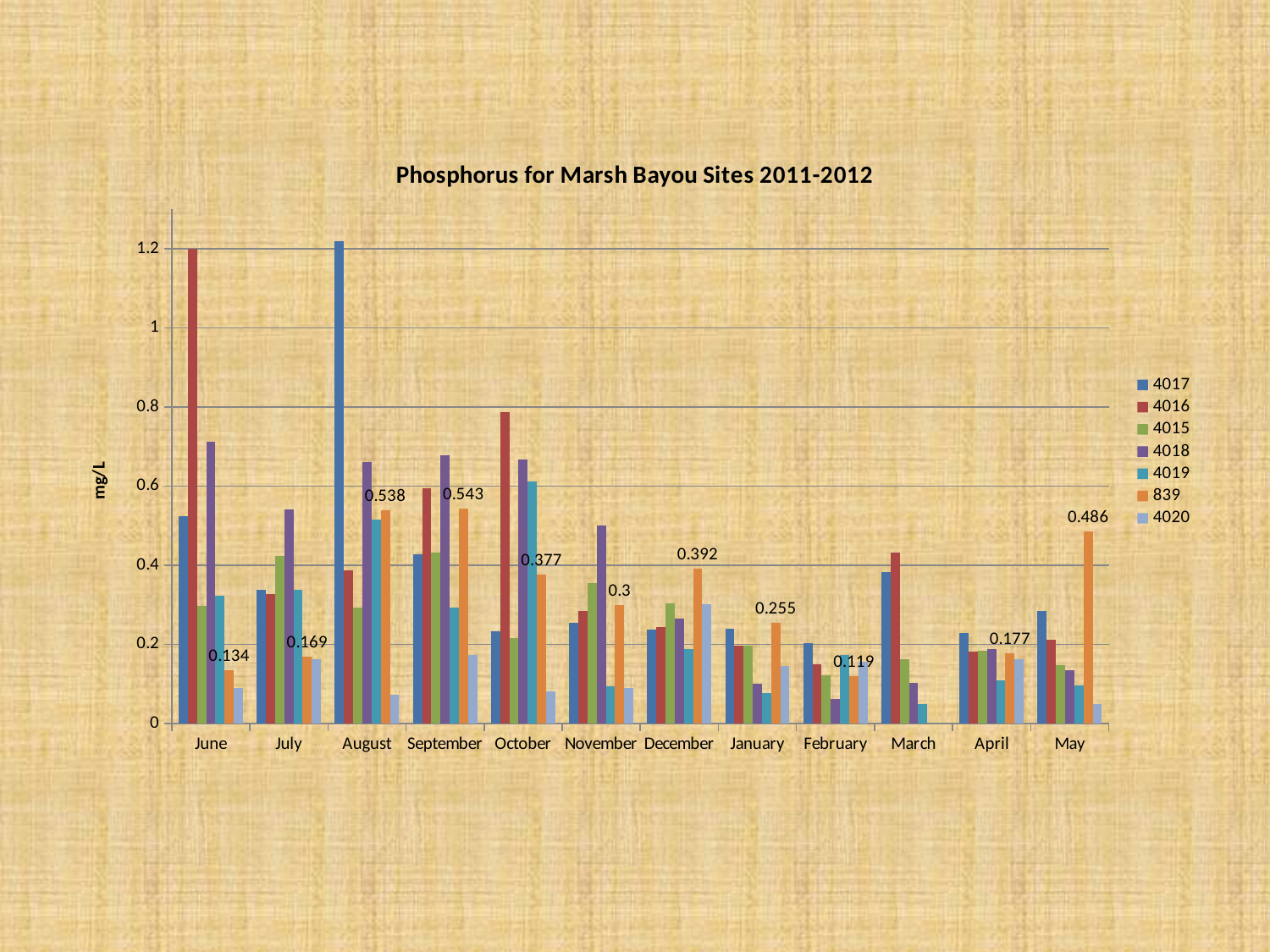
What is the difference between the site 839 values for May and April? 0.309 Which is larger for site 839: the December value or the January value? December In which month is the labelled value for site 839 lowest? February How many series does the legend list? 7 In which month is the labelled value for site 839 highest? September How many months are shown along the x axis? 12 Do the site 839 values rise or fall from June to September? rise What is the value for site 839 in August? 0.538 What is the value for site 839 in May? 0.486 Is the value for site 4017 in August greater or less than 1? greater What kind of chart is shown on the slide? bar chart What is the label on the vertical axis? mg/L